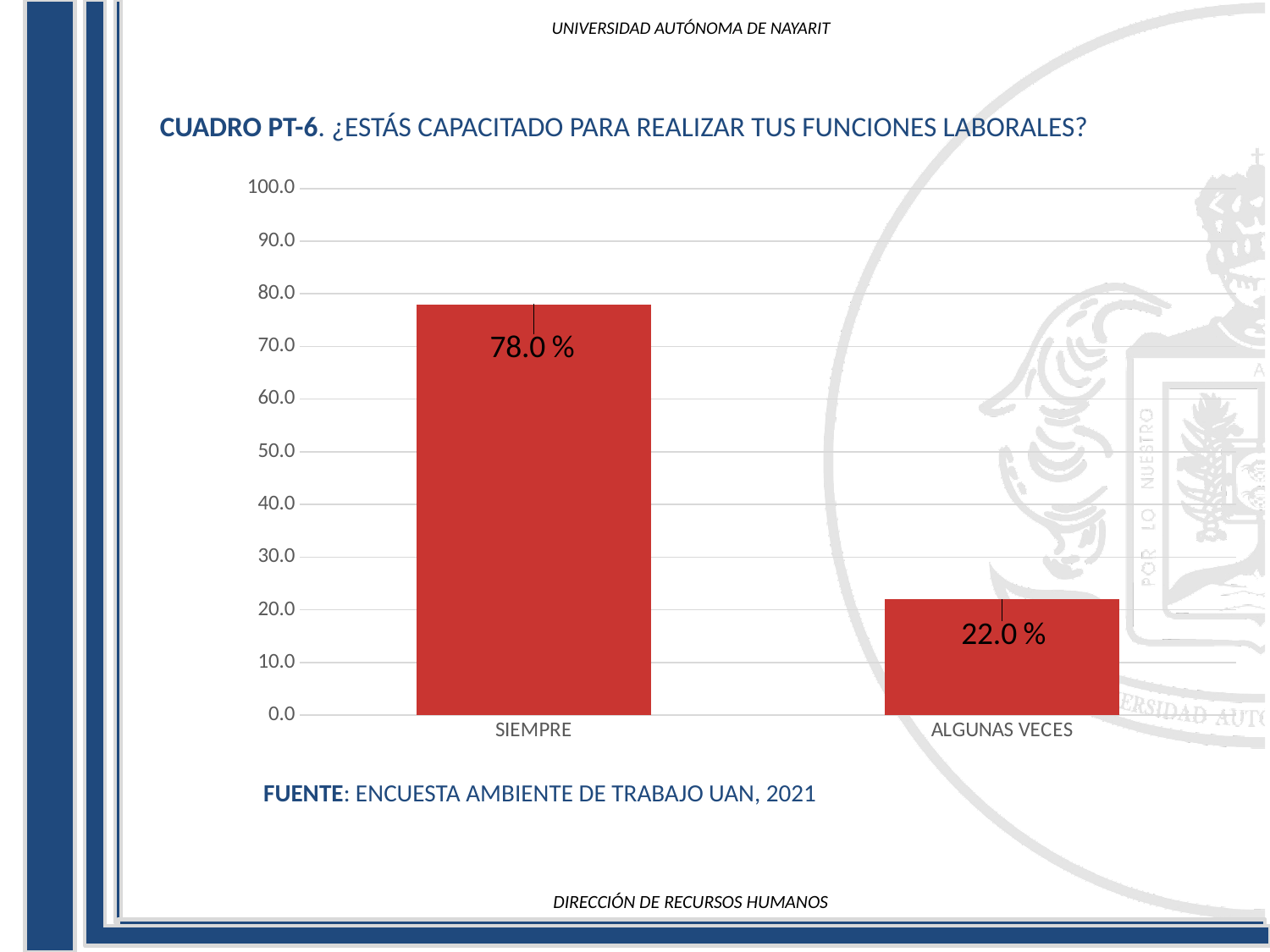
Which category has the lowest value? ALGUNAS VECES What is the value for ALGUNAS VECES? 22.0 % Is the value for ALGUNAS VECES greater or less than 30.0? less What kind of chart is shown on the slide? bar chart How many categories are shown on the x axis? 2 What is the source cited below the chart? ENCUESTA AMBIENTE DE TRABAJO UAN, 2021 What is the maximum value shown on the y axis? 100.0 Which is larger, the value for SIEMPRE or the value for ALGUNAS VECES? SIEMPRE What is the value for SIEMPRE? 78.0 % Which category has the highest value? SIEMPRE Is the value for SIEMPRE greater or less than 70.0? greater What is the difference between the values for SIEMPRE and ALGUNAS VECES? 56.0 %